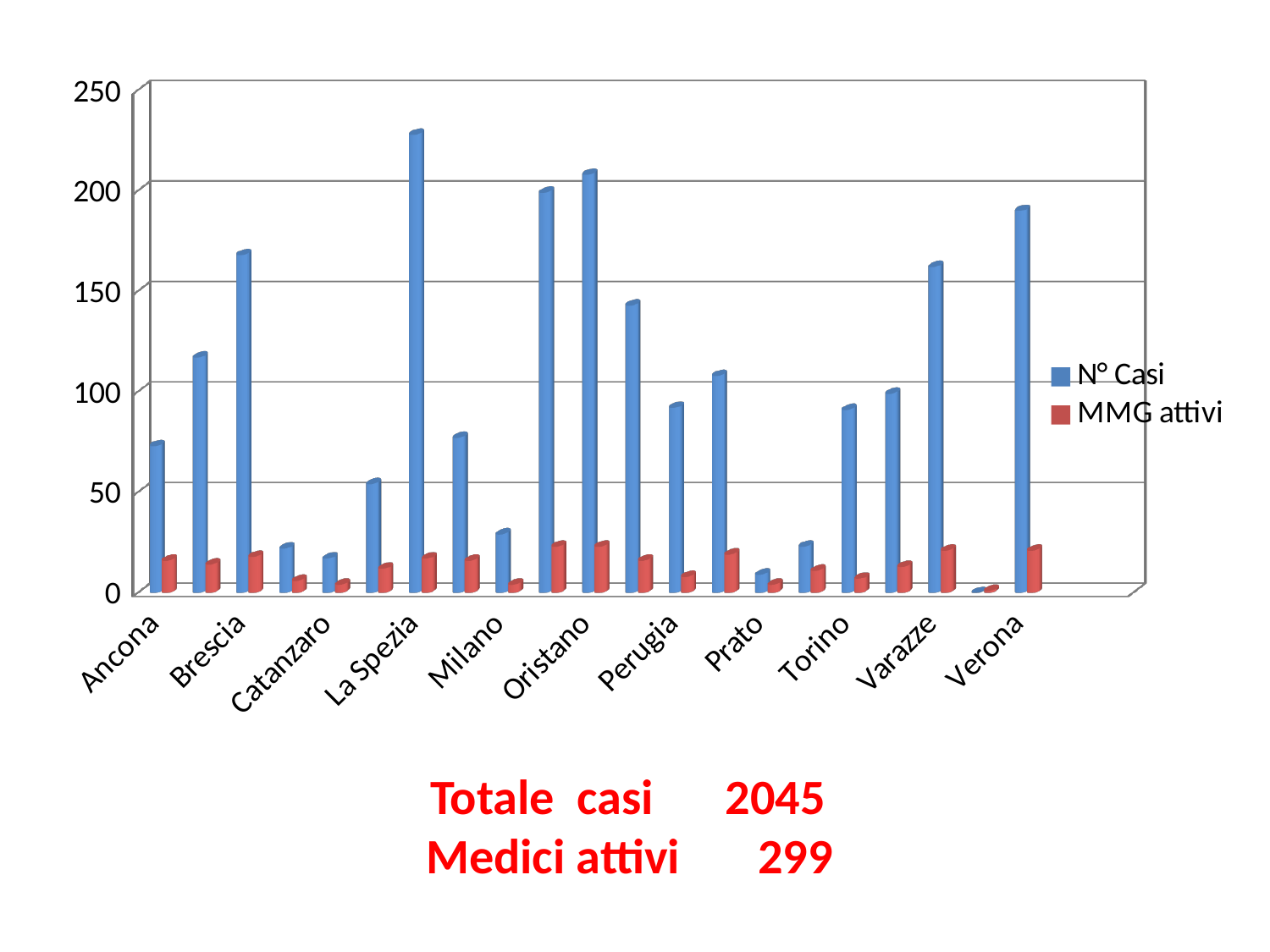
Which colour represents the MMG attivi series? red Is the N° Casi value for La Spezia greater or less than 200? greater Which series has the larger value for La Spezia, N° Casi or MMG attivi? N° Casi How many series does the legend list? 2 What kind of chart is shown on the slide? bar chart Is the N° Casi value for Oristano greater or less than 200? greater What are the two series named in the legend? N° Casi and MMG attivi Which city has the highest N° Casi value? La Spezia Is the N° Casi value for Prato greater or less than 50? less